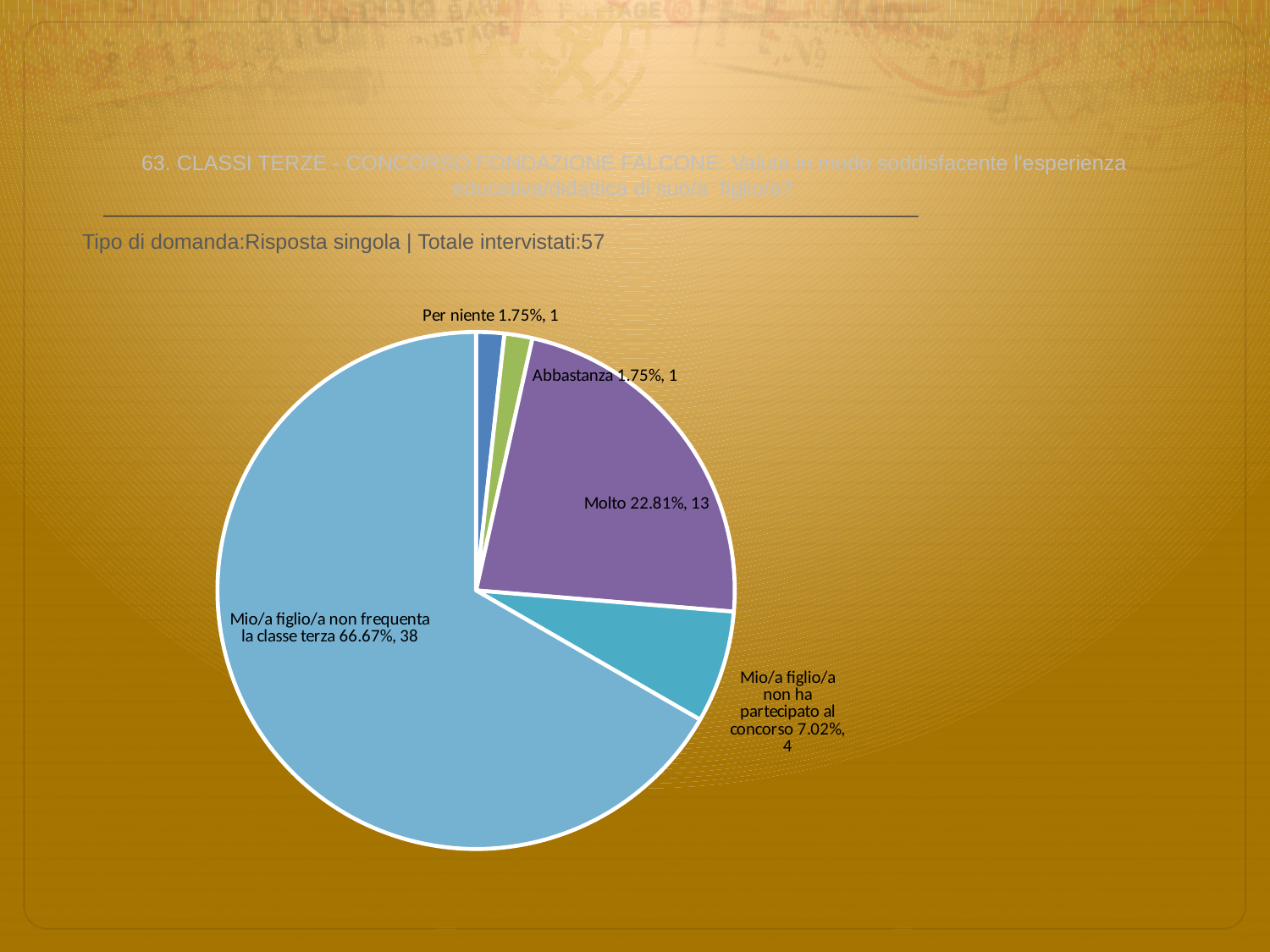
How many respondents answered 'Molto'? 13 What percentage share does the 'Abbastanza' slice have? 1.75% What kind of chart is shown on the slide? pie chart How many respondents answered 'Per niente'? 1 What percentage share does the 'Molto' slice have? 22.81% Which is larger, the 'Molto' slice or the 'Mio/a figlio/a non ha partecipato al concorso' slice? Molto How many slices does the pie chart have? 5 What is the total number of respondents stated on the slide? 57 Which category has the largest slice of the pie? Mio/a figlio/a non frequenta la classe terza What is the difference in respondent count between 'Mio/a figlio/a non frequenta la classe terza' and 'Molto'? 25 What percentage share does the 'Mio/a figlio/a non frequenta la classe terza' slice have? 66.67% How many respondents answered 'Mio/a figlio/a non ha partecipato al concorso'? 4